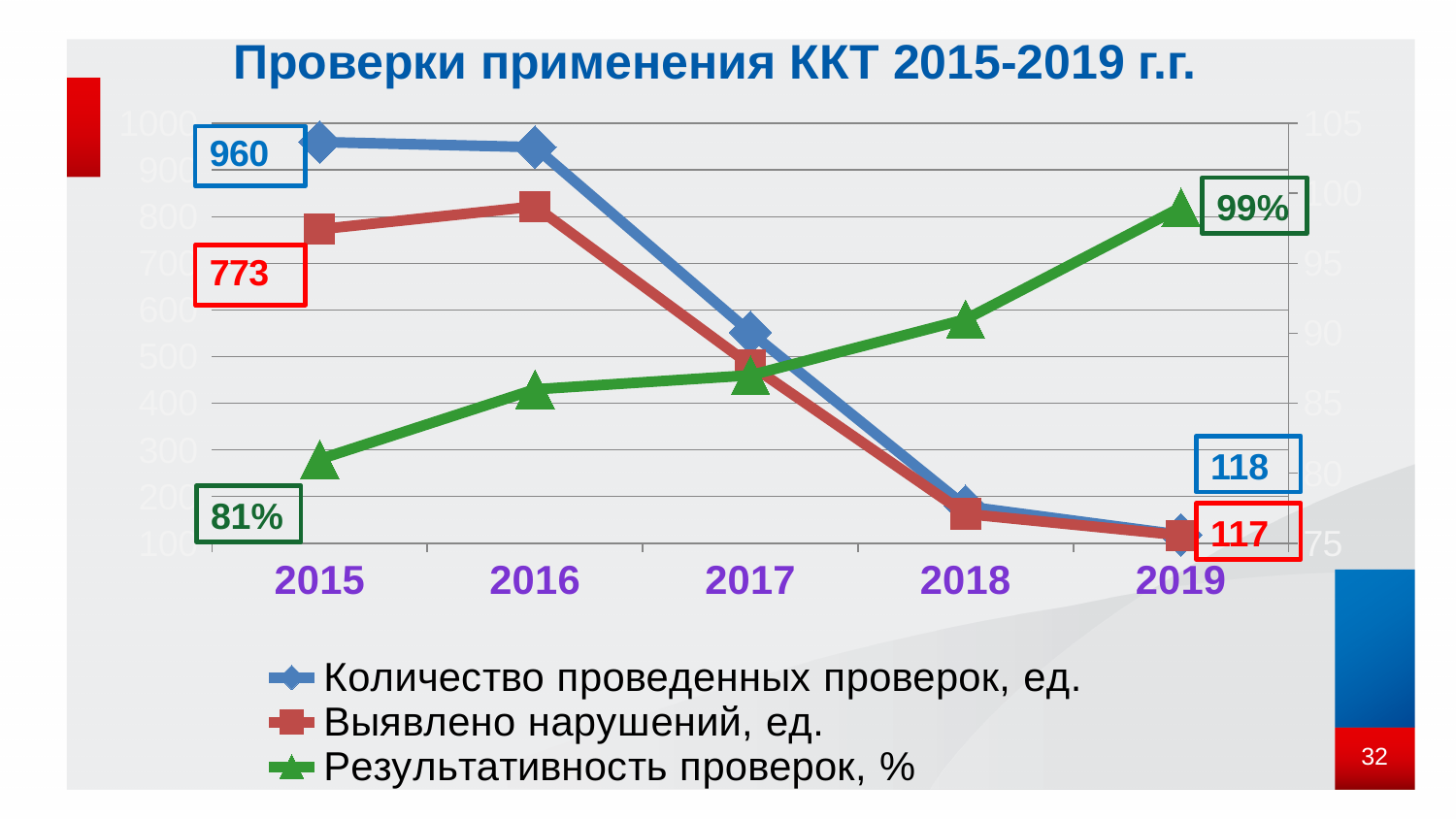
Is the value of 'Количество проведенных проверок, ед.' in 2018 greater or less than 300? less What is the value of 'Количество проведенных проверок, ед.' in 2019? 118 In which year is 'Результативность проверок, %' the highest? 2019 What is the value of 'Количество проведенных проверок, ед.' in 2015? 960 What is the value of 'Выявлено нарушений, ед.' in 2015? 773 How many series does the legend list? 3 What is the value of 'Результативность проверок, %' in 2019? 99% What is the value of 'Результативность проверок, %' in 2015? 81% In 2019, which is larger: 'Количество проведенных проверок, ед.' or 'Выявлено нарушений, ед.'? Количество проведенных проверок, ед. What kind of chart is shown on the slide? line chart What is the difference between 'Выявлено нарушений, ед.' in 2015 and in 2019? 656 By how much did 'Количество проведенных проверок, ед.' decrease from 2015 to 2019? 842